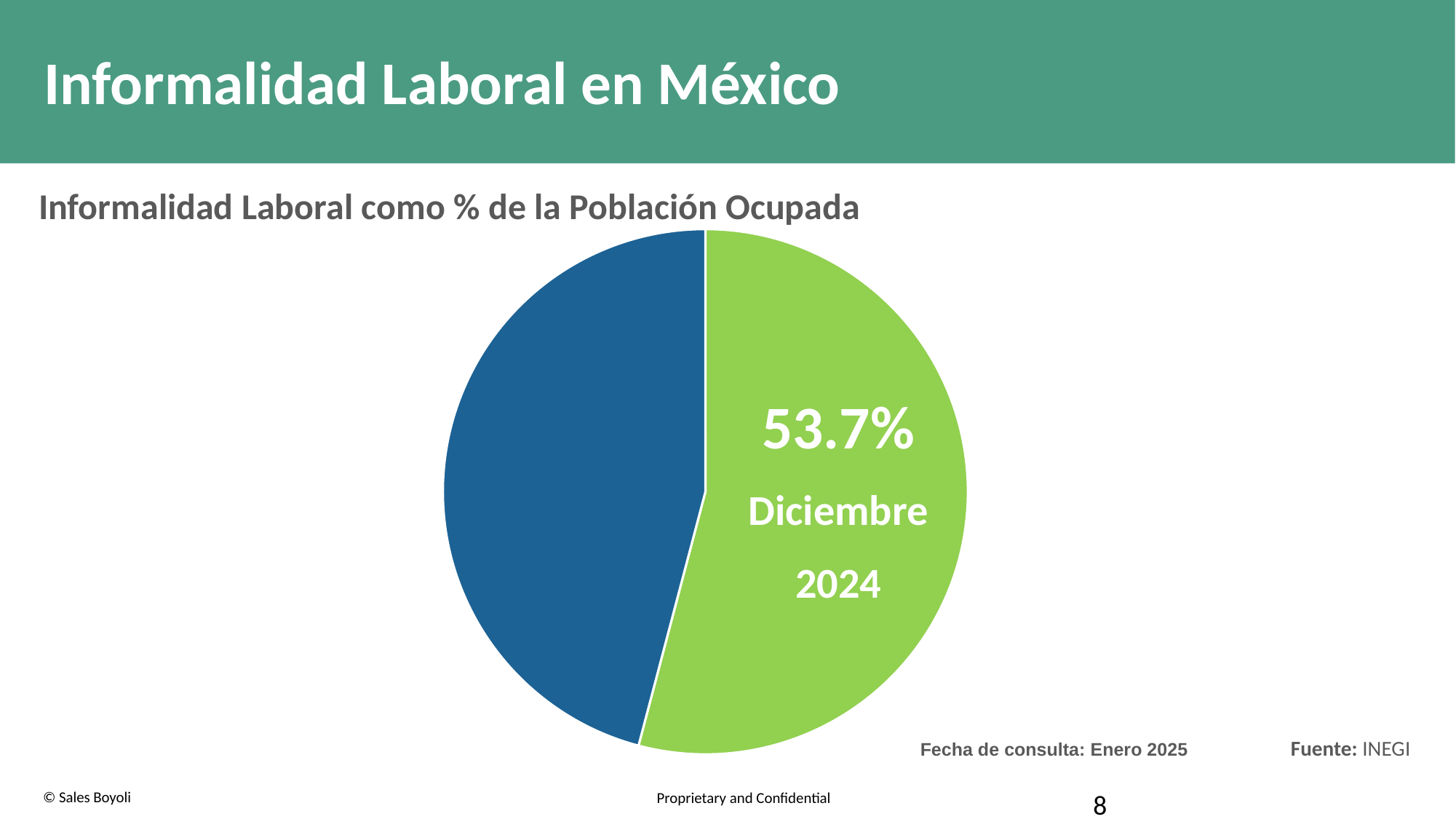
What colour is the slice that carries the 53.7% label? green Is the blue slice of the pie chart greater or less than 50%? less What percentage is printed on the green slice of the pie chart? 53.7% Which period does the 53.7% value on the pie chart refer to? Diciembre 2024 What share of the pie does the green slice represent? 53.7% Which slice of the pie chart is larger, the green one or the blue one? the green one What kind of chart is shown on the slide? pie chart Is the green slice of the pie chart greater or less than 50%? greater What is the title of the chart? Informalidad Laboral como % de la Población Ocupada How many slices does the pie chart have? 2